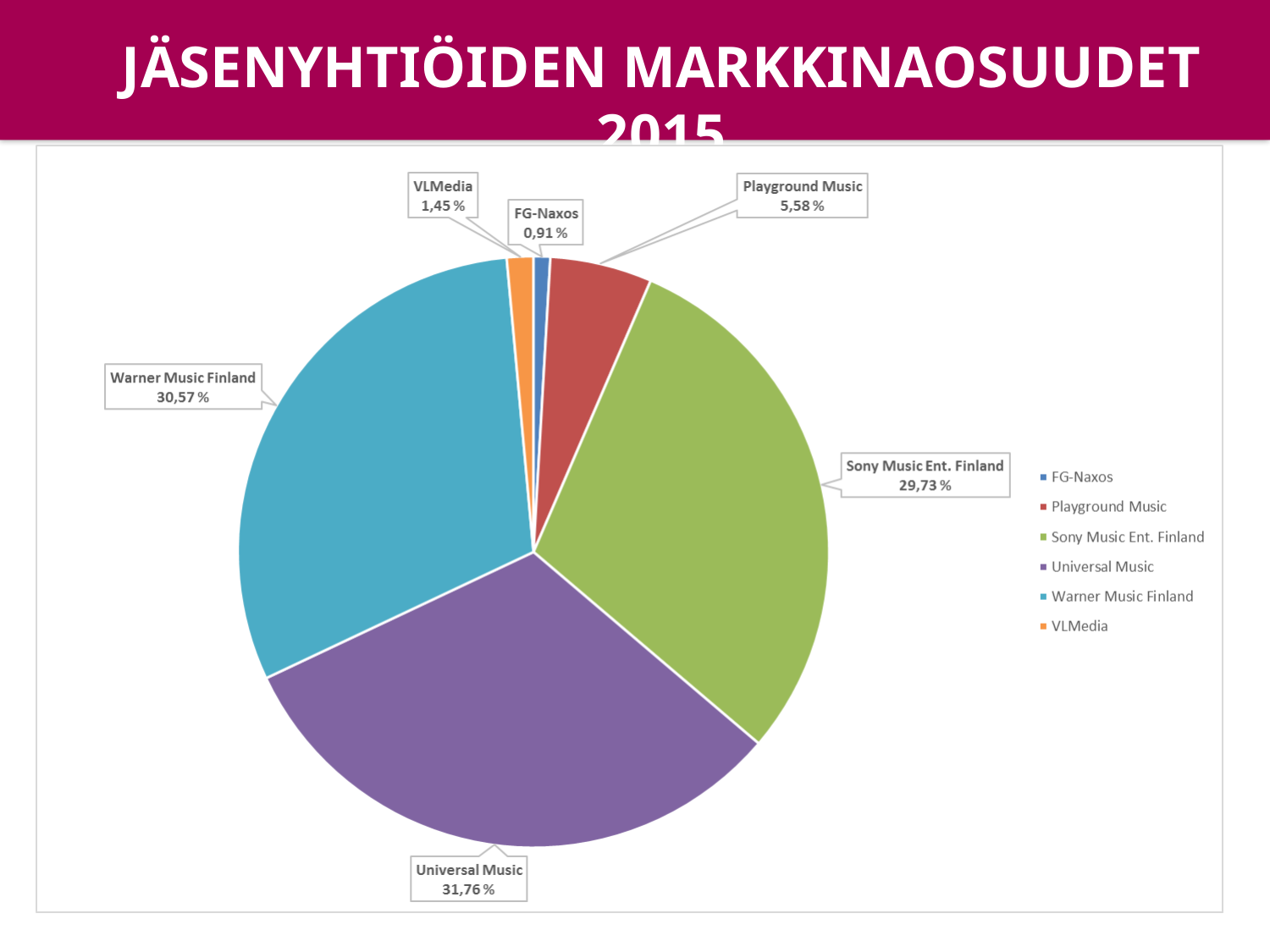
What is the market share of Playground Music? 5,58 % What is the market share of Sony Music Ent. Finland? 29,73 % How many companies are shown in the pie chart? 6 Which company has the smallest market share? FG-Naxos What is the difference in market share between Universal Music and Warner Music Finland? 1,19 % What is the market share of Universal Music? 31,76 % What is the market share of FG-Naxos? 0,91 % Which has a larger market share, VLMedia or FG-Naxos? VLMedia Which company has the largest market share? Universal Music What type of chart is shown on the slide? pie chart What colour is the slice for Sony Music Ent. Finland? green What is the market share of Warner Music Finland? 30,57 %